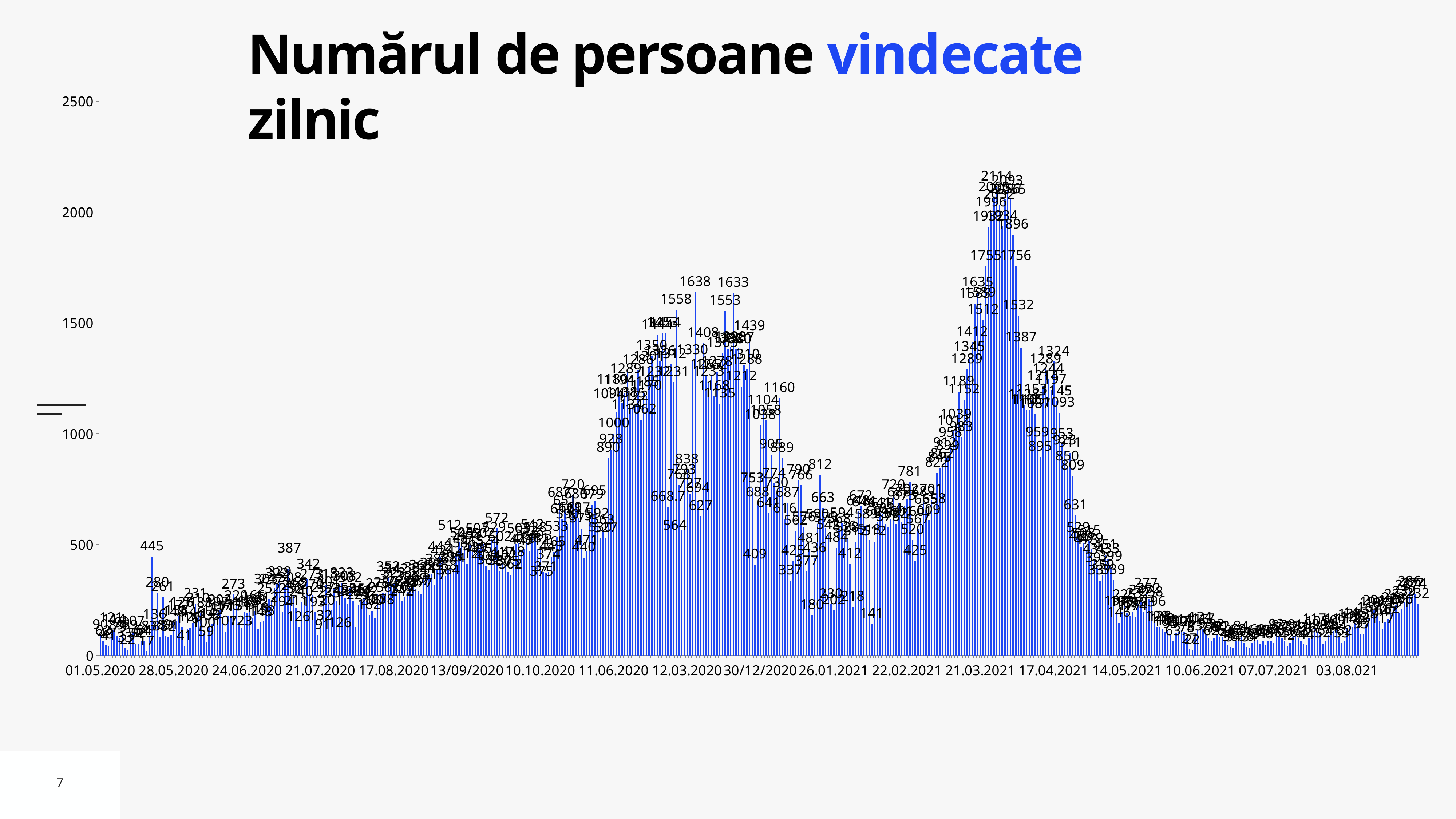
What is the difference between the highest labelled value (2114) and the peak labelled 1638? 476 What is the highest value labelled on the chart? 2114 What is the maximum value shown on the y axis? 2500 Is the highest value on the chart greater or less than 2000? greater What kind of chart is shown on the slide? bar chart Do the values rise or fall between 14.05.2021 and 10.06.2021? fall What is the title of the chart? Numărul de persoane vindecate zilnic What is the value of the tallest bar near 24.06.2020? 387 Is the value of the first bar at 01.05.2020 greater or less than 500? less What is the value of the tallest bar near 28.05.2020? 445 Do the values rise or fall between 07.07.2021 and 03.08.2021? rise Which is larger, the peak labelled 1638 or the peak labelled 2114? 2114